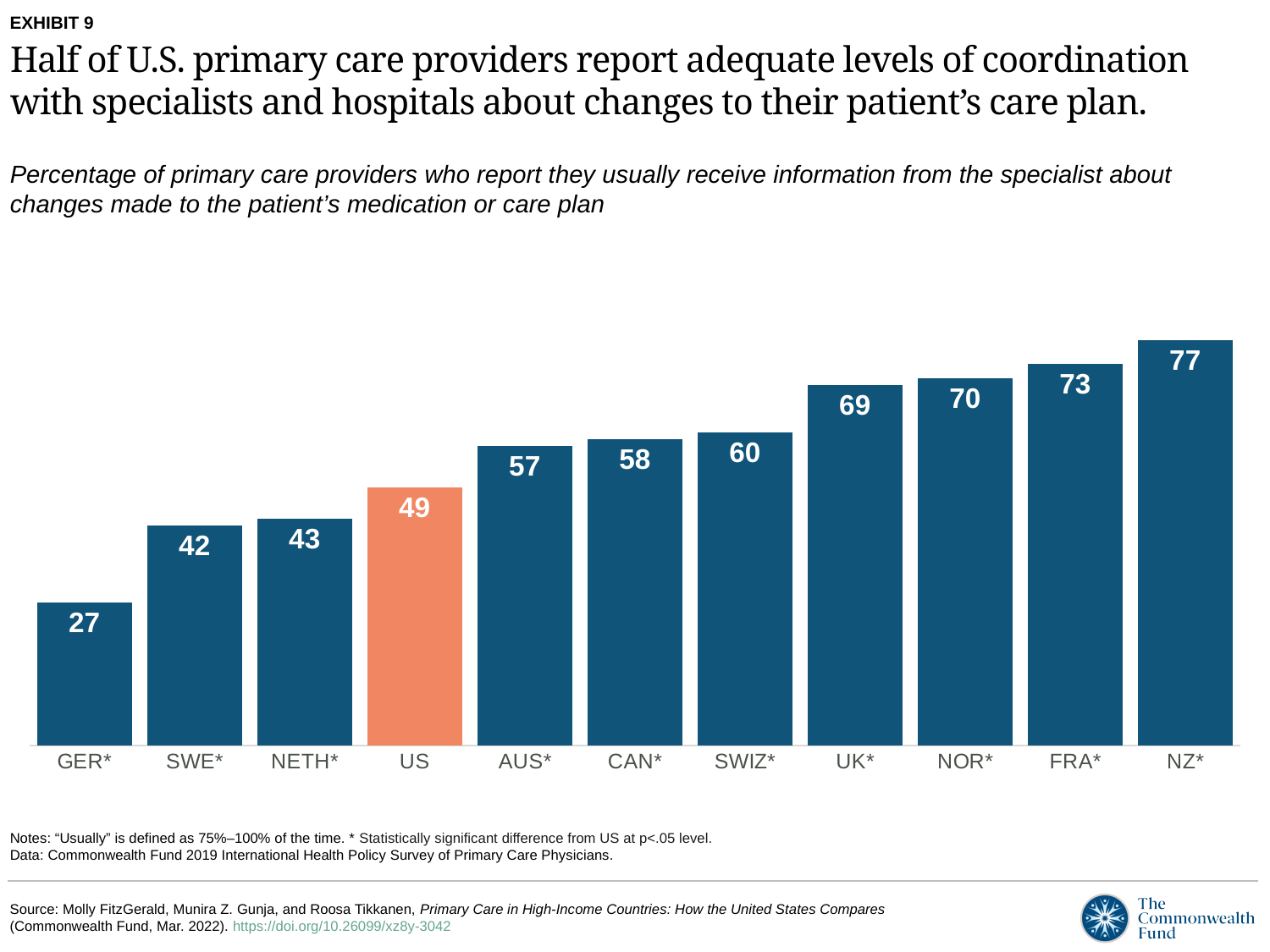
What is the value for SWIZ*? 60 Which is larger, the value for UK* or the value for CAN*? UK* Do the values rise or fall from left to right along the x axis? rise Which bar is shown in a different colour (orange) from the others? US What kind of chart is this? bar chart What is the difference between the values for NZ* and US? 28 How many countries are shown in the chart? 11 What is the value for GER*? 27 Which country has the highest value? NZ* What is the difference between the values for SWE* and NETH*? 1 Which country has the lowest value? GER* What is the value for US? 49